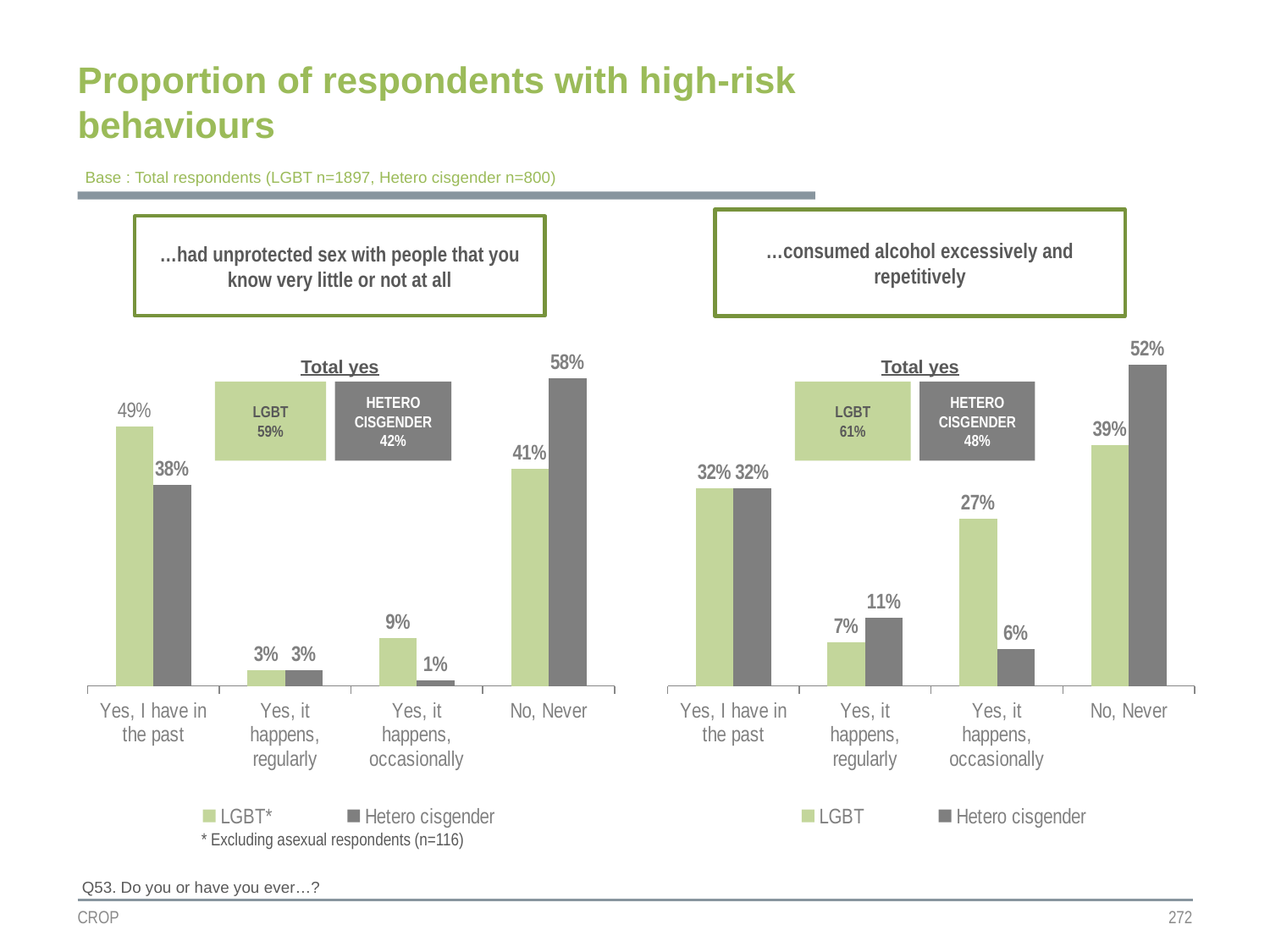
In the right chart (alcohol), which category has the highest Hetero cisgender value? No, Never In the left chart (unprotected sex), which category has the lowest Hetero cisgender value? Yes, it happens, occasionally In the left chart (unprotected sex), what is the difference between the LGBT and Hetero cisgender values for 'Yes, I have in the past'? 11% How many categories are shown on the x axis of the left chart (unprotected sex)? 4 In the left chart (unprotected sex), what is the LGBT value for 'Yes, I have in the past'? 49% In the right chart (alcohol), what is the Hetero cisgender value for 'Yes, it happens, regularly'? 11% In the right chart (alcohol), what is the LGBT value for 'Yes, it happens, occasionally'? 27% In the right chart (alcohol), what is the difference between the Hetero cisgender and LGBT values for 'No, Never'? 13% In the right chart (alcohol), which is larger for 'Yes, it happens, occasionally': LGBT or Hetero cisgender? LGBT How many series does the legend of the right chart (alcohol) list? 2 In the left chart (unprotected sex), what is the Hetero cisgender value for 'No, Never'? 58% What is the 'Total yes' value for LGBT in the right chart (alcohol)? 61%